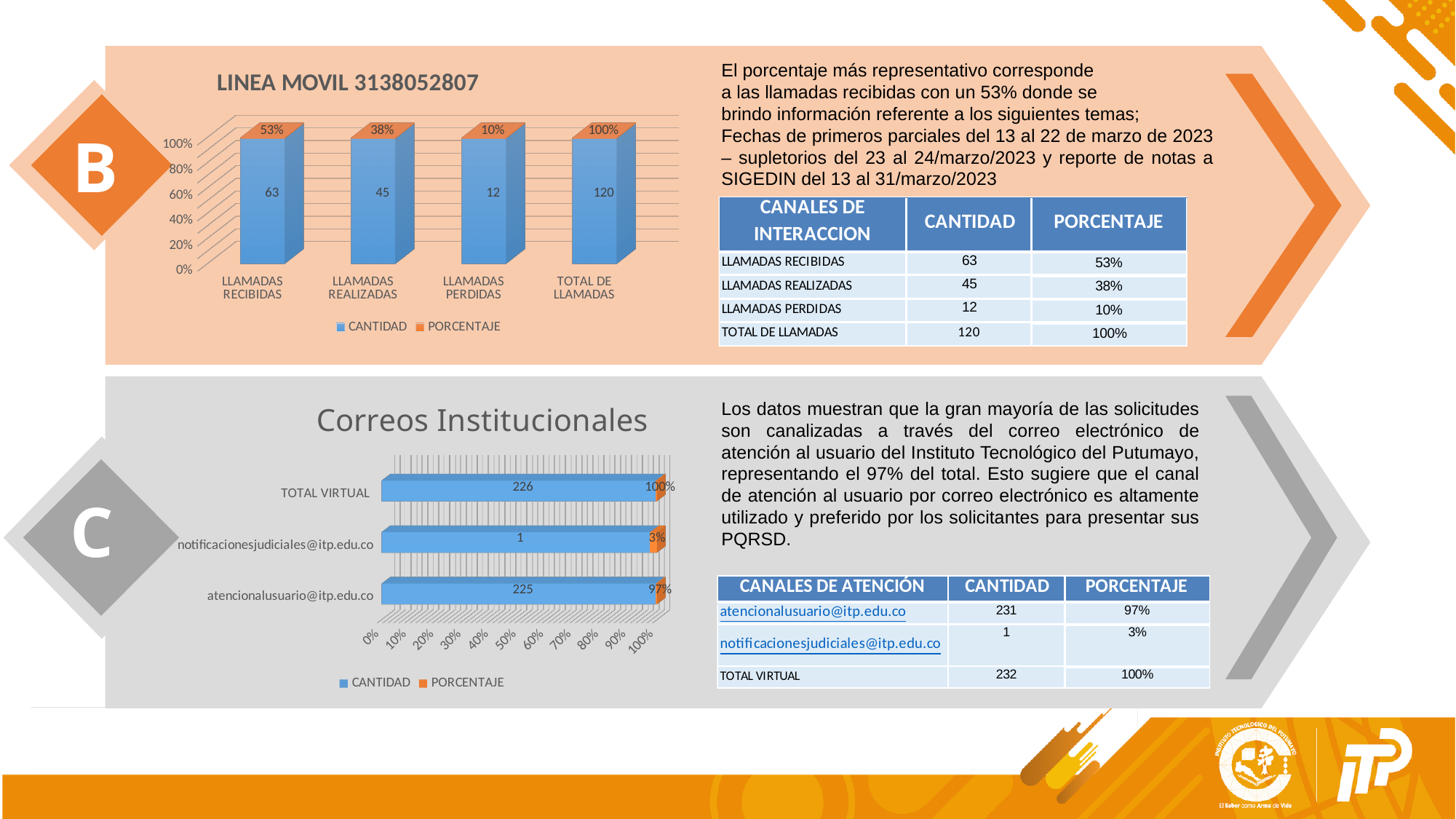
In the LINEA MOVIL 3138052807 chart, how many categories are shown on the x axis? 4 In the Correos Institucionales chart, what are the two series listed in the legend? CANTIDAD and PORCENTAJE In the Correos Institucionales chart, what PORCENTAJE is shown for notificacionesjudiciales@itp.edu.co? 3% In the LINEA MOVIL 3138052807 chart, which category has the lowest CANTIDAD value? LLAMADAS PERDIDAS In the LINEA MOVIL 3138052807 chart, what is the difference between the CANTIDAD values for LLAMADAS RECIBIDAS and LLAMADAS REALIZADAS? 18 In the LINEA MOVIL 3138052807 chart, how many series does the legend list? 2 In the Correos Institucionales chart, which category has the highest CANTIDAD value? TOTAL VIRTUAL In the Correos Institucionales chart, what is the CANTIDAD value for atencionalusuario@itp.edu.co? 225 What kind of chart is the Correos Institucionales chart? Bar chart In the LINEA MOVIL 3138052807 chart, what is the CANTIDAD value for LLAMADAS RECIBIDAS? 63 In the Correos Institucionales chart, which has a larger CANTIDAD value: atencionalusuario@itp.edu.co or notificacionesjudiciales@itp.edu.co? atencionalusuario@itp.edu.co In the LINEA MOVIL 3138052807 chart, what PORCENTAJE is shown for LLAMADAS REALIZADAS? 38%